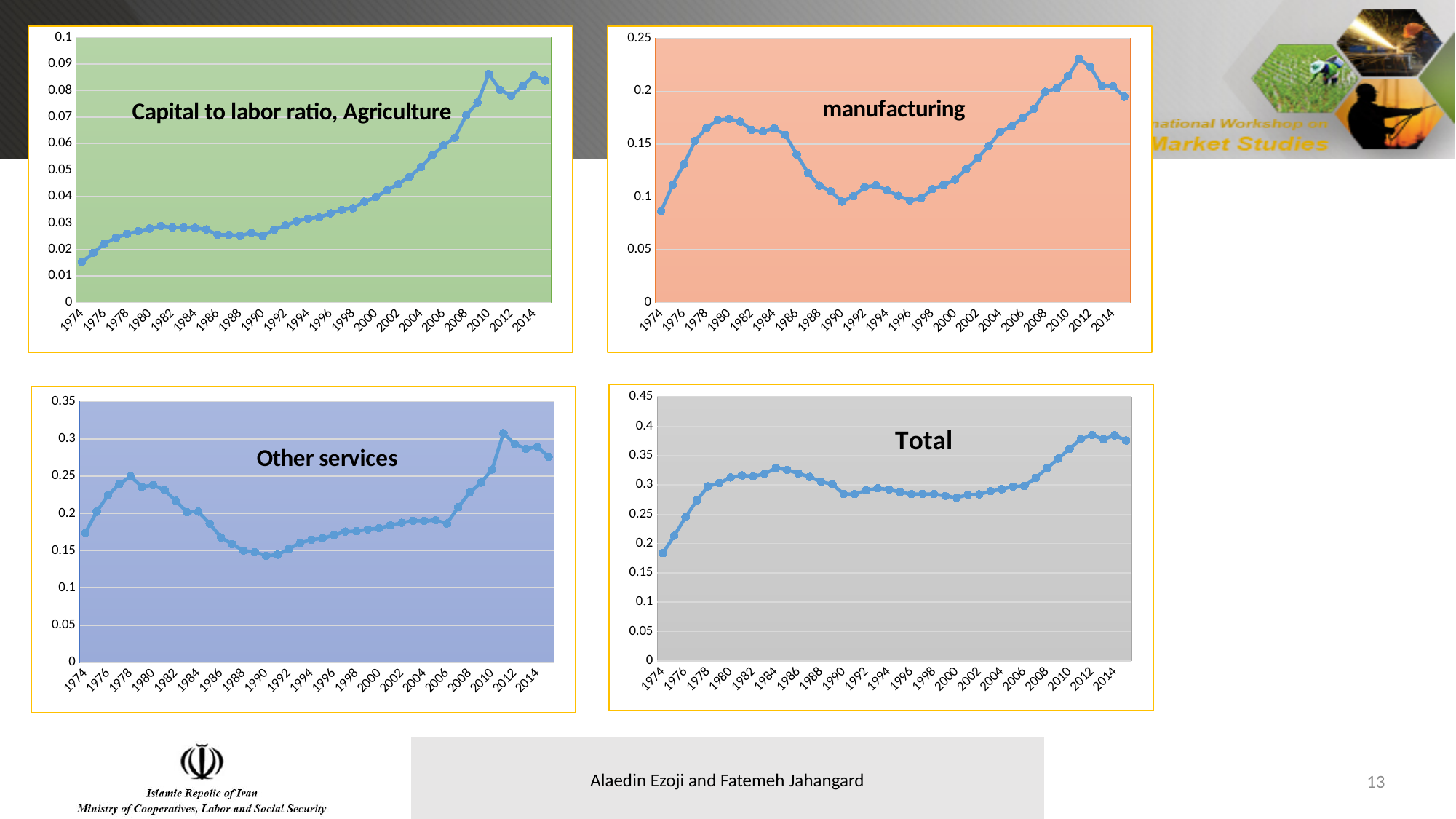
In the 'Capital to labor ratio, Agriculture' chart, do the values overall rise or fall from 1974 to 2015? rise In the 'Other services' chart, is the value for 1990 greater or less than 0.2? less In the 'Capital to labor ratio, Agriculture' chart, is the value for 1974 greater or less than 0.02? less In the 'Capital to labor ratio, Agriculture' chart, is the value for 2010 greater or less than 0.08? greater What kind of chart is the 'Capital to labor ratio, Agriculture' chart? line chart In the 'manufacturing' chart, in which year does the line reach its highest value? 2011 How many charts are shown on the slide? 4 What is the title of the chart at the bottom right of the slide? Total